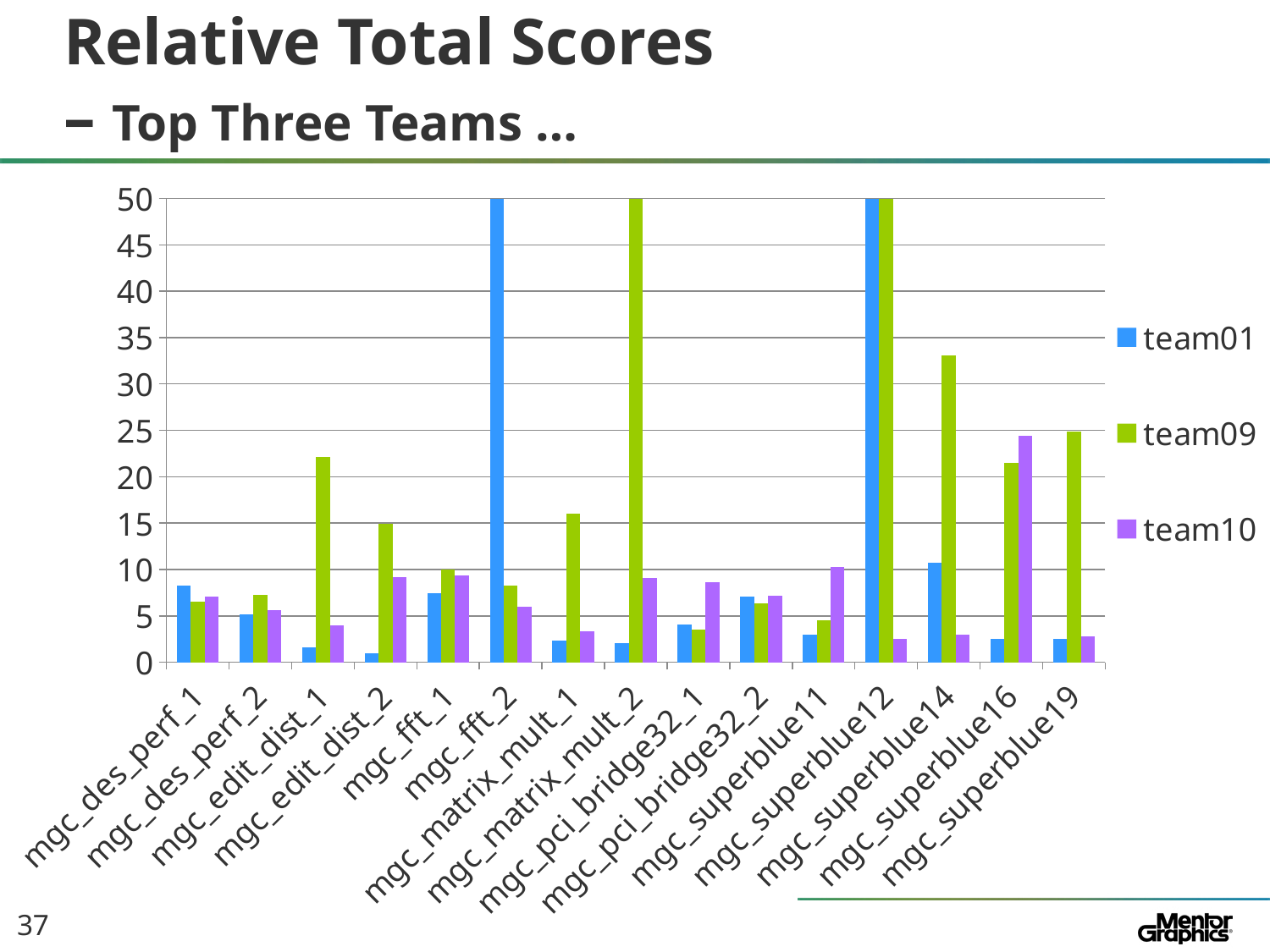
Is the value for team10 at mgc_superblue16 greater or less than 20? greater How many series does the legend list? 3 Which teams are listed in the legend? team01, team09, team10 At mgc_pci_bridge32_1, which is larger: team01 or team10? team10 Is the value for team09 at mgc_edit_dist_1 greater or less than 20? greater What kind of chart is shown on the slide? bar chart Is the value for team01 at mgc_edit_dist_2 greater or less than 5? less How many categories are shown on the x axis? 15 What colour are the team09 bars? green Which team has the highest bar at mgc_superblue14? team09 For which category is the team10 bar the highest? mgc_superblue16